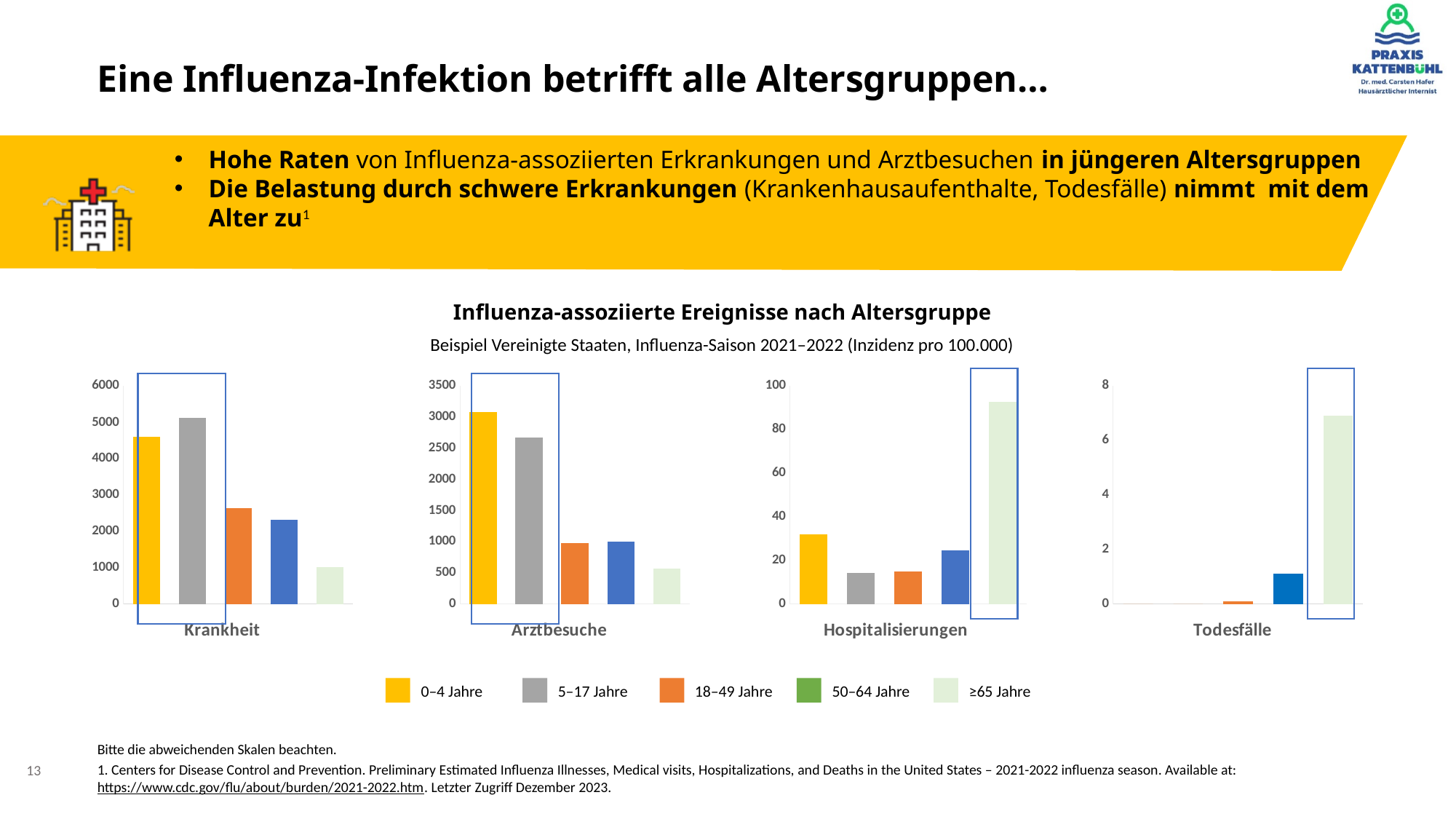
In the Krankheit chart, which age group has the highest value? 5–17 Jahre In the Arztbesuche chart, which is larger, the value for 0–4 Jahre or for 18–49 Jahre? 0–4 Jahre In the Krankheit chart, which age group has the lowest value? ≥65 Jahre In the Hospitalisierungen chart, is the value for ≥65 Jahre greater or less than 80? greater How many age groups does the legend list? 5 What is the title of the chart group on the slide? Influenza-assoziierte Ereignisse nach Altersgruppe In the Hospitalisierungen chart, which age group has the highest value? ≥65 Jahre In the Arztbesuche chart, which age group has the highest value? 0–4 Jahre What kind of chart is the Krankheit chart? bar chart In the Krankheit chart, is the value for 0–4 Jahre greater or less than 4000? greater In the Arztbesuche chart, is the value for 5–17 Jahre greater or less than 3000? less